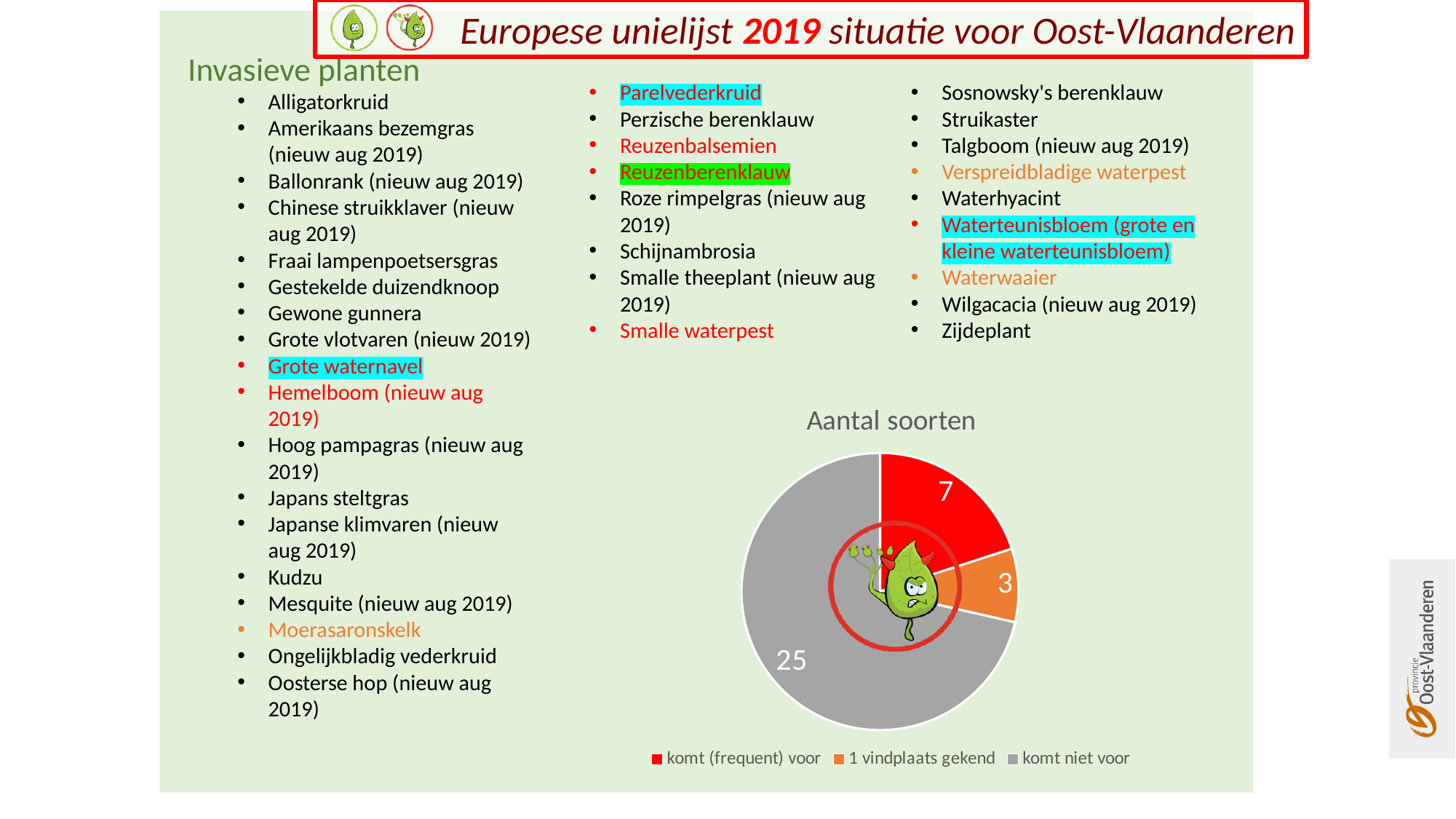
What is the value for 'komt (frequent) voor'? 7 Which is larger, the value for 'komt (frequent) voor' or the value for '1 vindplaats gekend'? komt (frequent) voor Which category has the largest slice of the pie? komt niet voor What is the title of the chart? Aantal soorten How many entries does the chart legend list? 3 What type of chart is shown on the slide? pie chart What is the difference between the values for 'komt niet voor' and 'komt (frequent) voor'? 18 What is the value for 'komt niet voor'? 25 What is the total of all slices in the pie chart? 35 What is the value for '1 vindplaats gekend'? 3 How many slices does the pie chart have? 3 Which category has the smallest slice of the pie? 1 vindplaats gekend